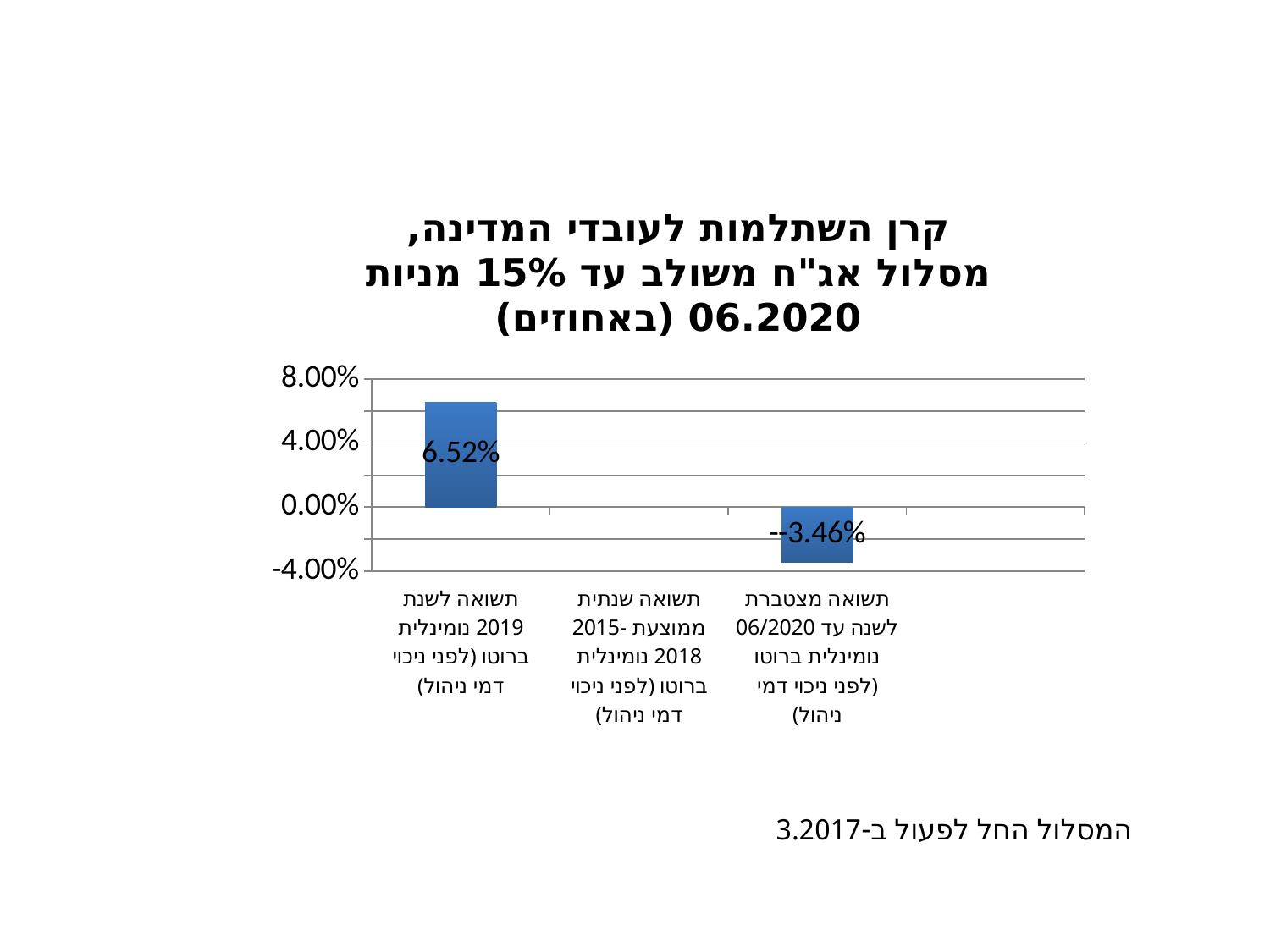
How many categories are shown on the x axis? 3 What kind of chart is shown on the slide? Bar chart According to the note below the chart, when did the track start operating? 3.2017 What is the value for the 2019 nominal gross return (תשואה לשנת 2019 נומינלית ברוטו)? 6.52% What is the value for the cumulative return for the year to 06/2020 (תשואה מצטברת לשנה עד 06/2020)? -3.46% What is the difference in percentage points between the 2019 return (6.52%) and the cumulative return to 06/2020 (-3.46%)? 9.98 percentage points What is the title of the chart? קרן השתלמות לעובדי המדינה, מסלול אג"ח משולב עד 15% מניות 06.2020 (באחוזים) Which category has the lowest plotted value? תשואה מצטברת לשנה עד 06/2020 נומינלית ברוטו (לפני ניכוי דמי ניהול) Which is larger: the 2019 return or the cumulative return to 06/2020? The 2019 return Which category has the highest value? תשואה לשנת 2019 נומינלית ברוטו (לפני ניכוי דמי ניהול) Is the value for the cumulative return to 06/2020 greater or less than 0.00%? less Is the value for the 2019 return greater or less than 4.00%? greater